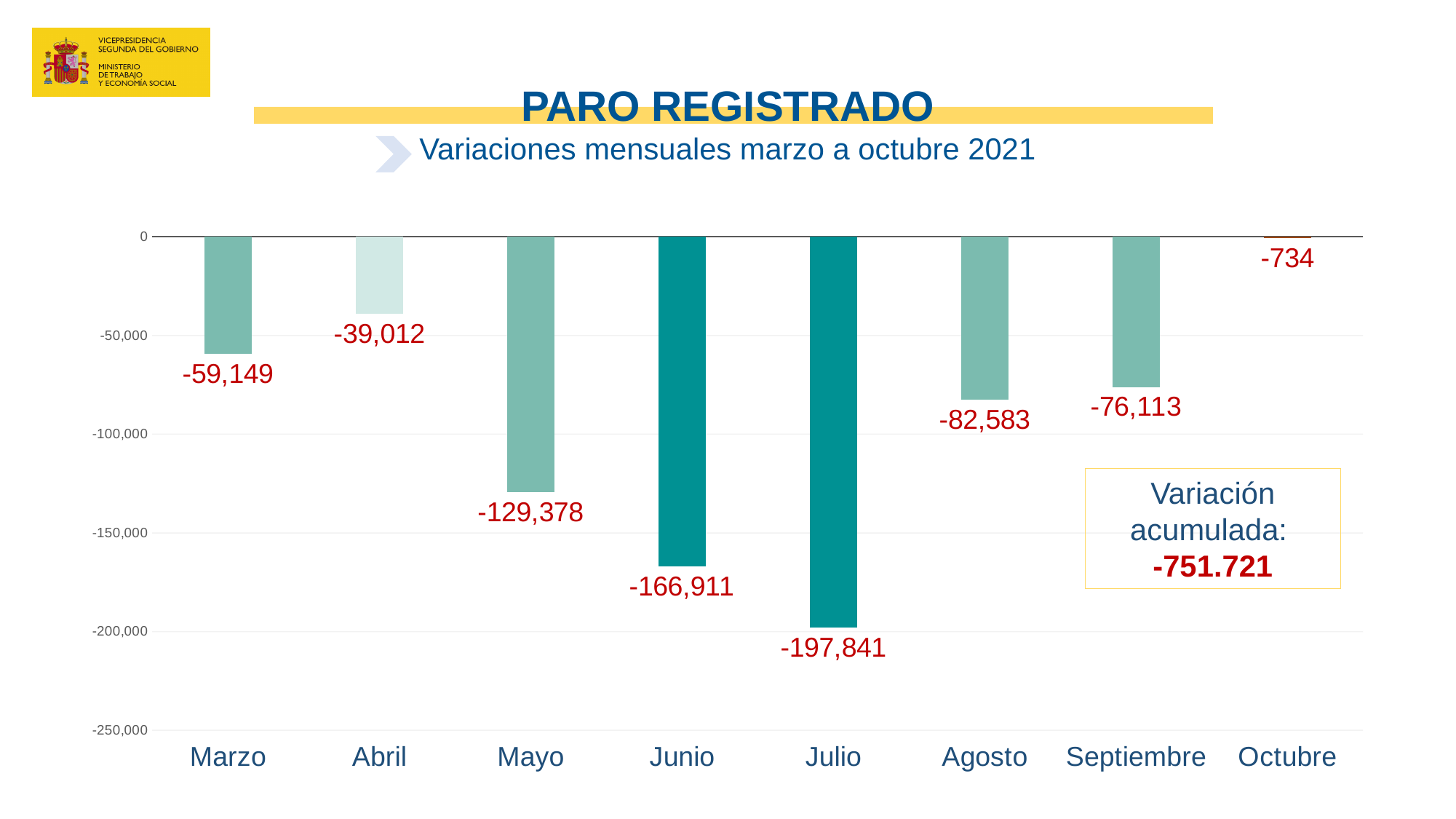
Which month has the lowest (most negative) value? Julio Is the value for Agosto greater or less than -100,000? greater What is the difference between the values for Mayo and Abril? 90,366 What kind of chart is shown on the slide? bar chart What is the difference between the values for Julio and Junio? 30,930 What is the value for Abril? -39,012 Which is larger, the value for Agosto or the value for Septiembre? Septiembre What is the value for Septiembre? -76,113 How many months are shown on the x axis? 8 What accumulated variation (Variación acumulada) is shown in the box on the chart? -751.721 Which month has the highest value (closest to zero)? Octubre What is the value for Julio? -197,841